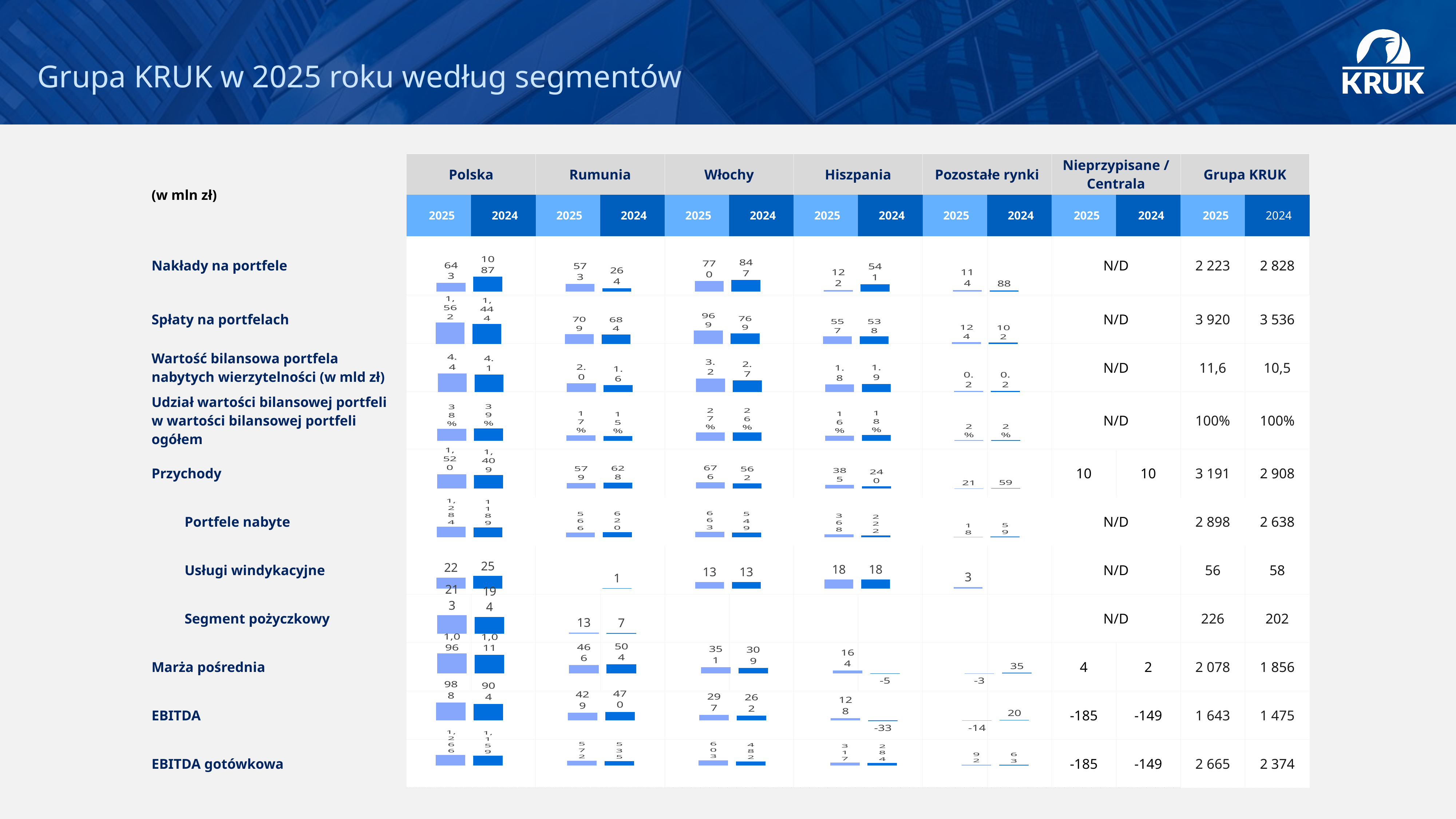
What kind of chart is used in the Usługi windykacyjne row for Polska? bar chart In the Segment pożyczkowy row for Rumunia, what is the difference between the 2025 and 2024 values? 6 In the EBITDA row, what is the value for Pozostałe rynki in 2025? -14 In the Segment pożyczkowy row, what is the value for Rumunia in 2024? 7 In the Marża pośrednia row, what is the value for Hiszpania in 2024? -5 In the Usługi windykacyjne row, what is the value for Polska in 2024? 25 In the Usługi windykacyjne row, what is the value for Pozostałe rynki in 2025? 3 In the EBITDA row, what is the value for Hiszpania in 2024? -33 In the Usługi windykacyjne row for Polska, what is the difference between the 2024 and 2025 values? 3 In the Usługi windykacyjne row for Polska, which year has the higher value, 2025 or 2024? 2024 In the Usługi windykacyjne row, what is the value for Polska in 2025? 22 In the Segment pożyczkowy row, what is the value for Rumunia in 2025? 13